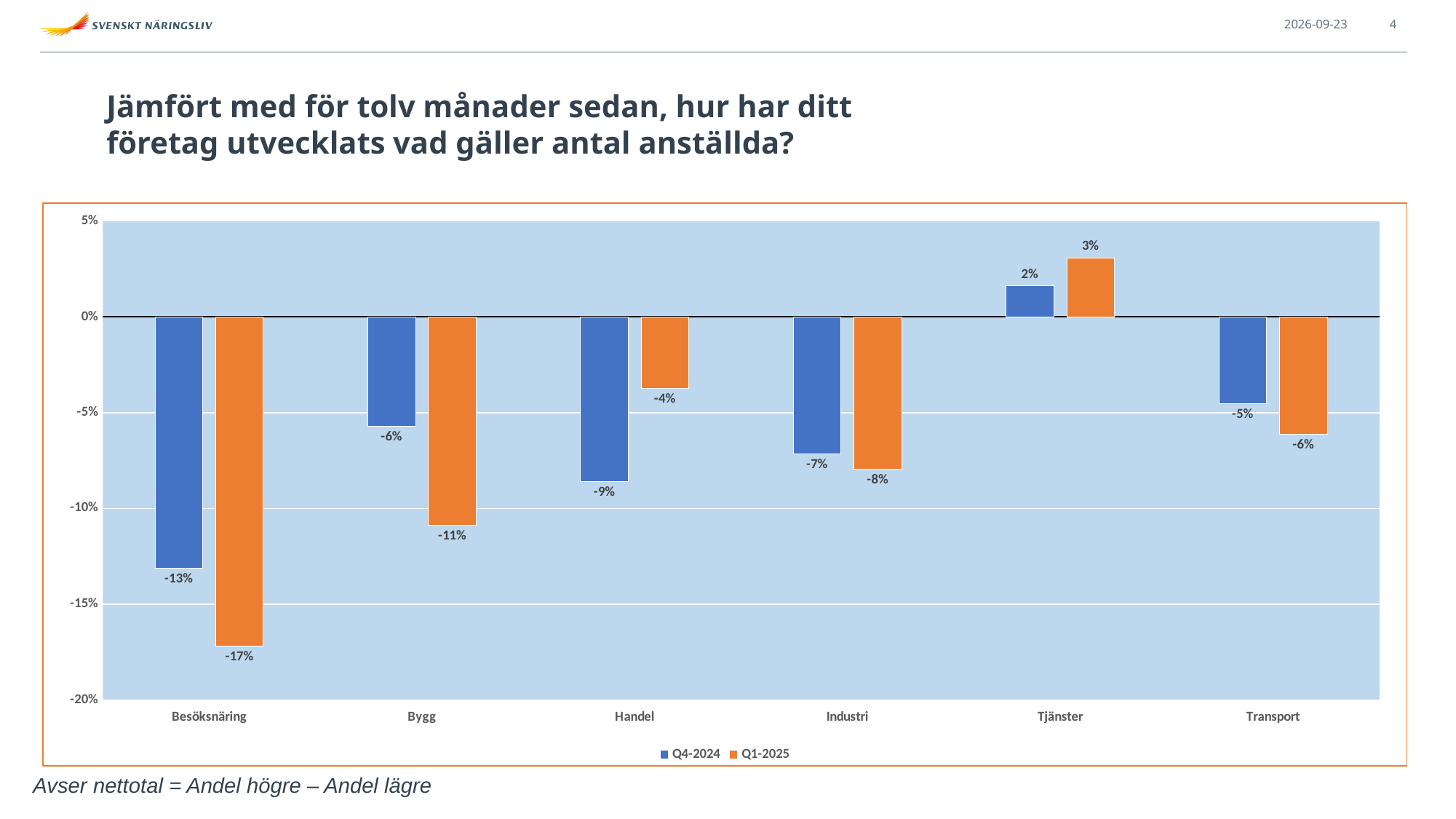
Which is larger for Handel, the Q4-2024 value or the Q1-2025 value? Q1-2025 Which category has the highest Q1-2025 value? Tjänster What is the Q1-2025 value for Besöksnäring? -17% What kind of chart is shown on the slide? Bar chart How many series does the legend list? 2 What is the Q4-2024 value for Transport? -5% What is the difference between the Q4-2024 and Q1-2025 values for Bygg? 5 percentage points What is the Q4-2024 value for Handel? -9% How many categories are shown on the x axis? 6 What is the Q1-2025 value for Tjänster? 3% Which colour represents the Q1-2025 series? Orange Which category has the lowest Q4-2024 value? Besöksnäring